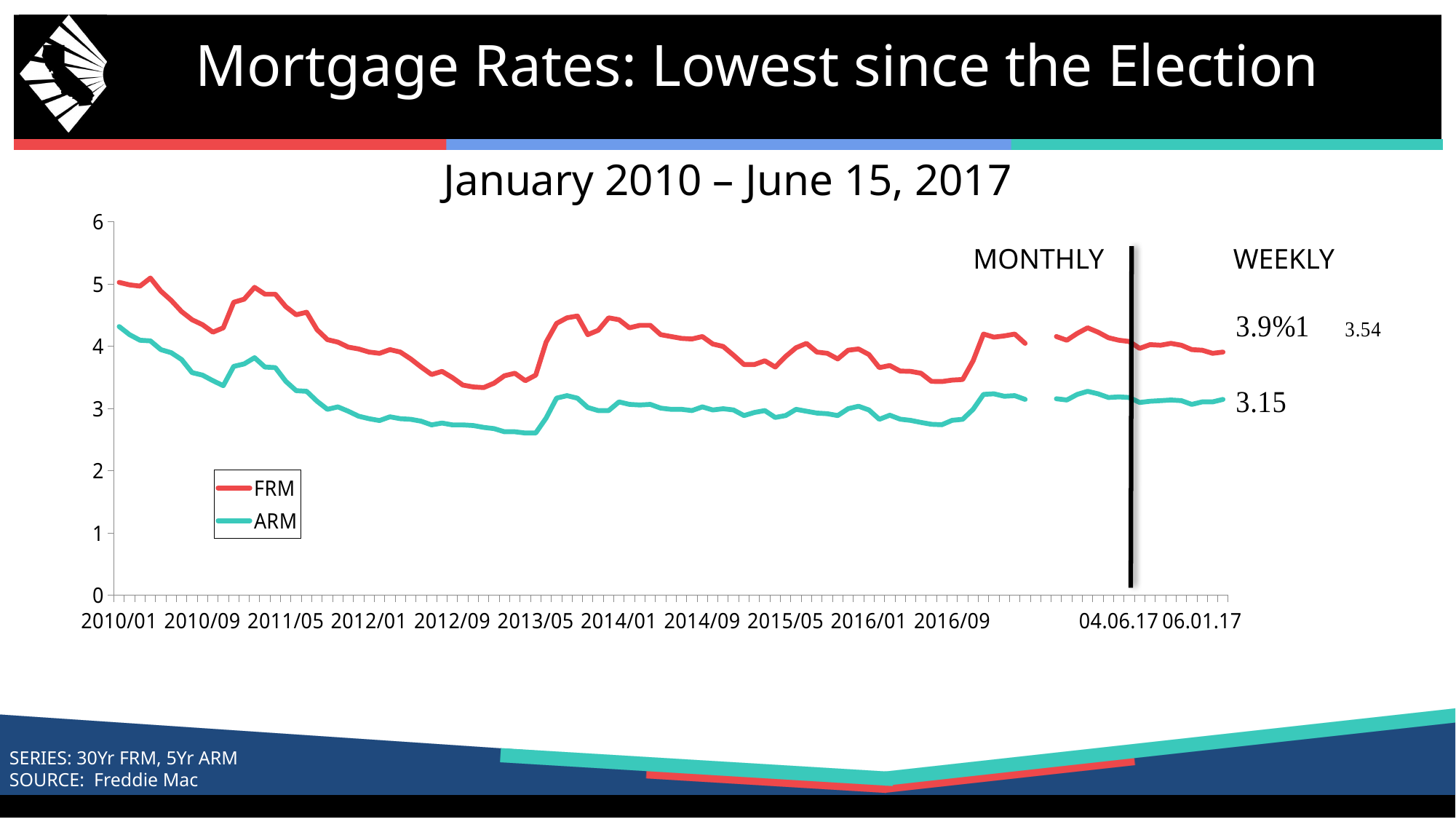
What kind of chart is shown on the slide? line chart Which series stays higher than the other across the whole chart? FRM Is the ARM value at 2016/09 greater or less than 3? less What are the two series named in the legend? FRM and ARM What value is labelled at the end of the ARM line in the weekly section? 3.15 How many series does the legend list? 2 Is the FRM value at 2013/01 greater or less than 4? less Does the FRM line rise or fall between 2010/01 and 2012/09? fall Is the ARM value at 2013/01 greater or less than 3? less What is the title shown above the chart? January 2010 – June 15, 2017 Which series is higher at 2010/01, FRM or ARM? FRM